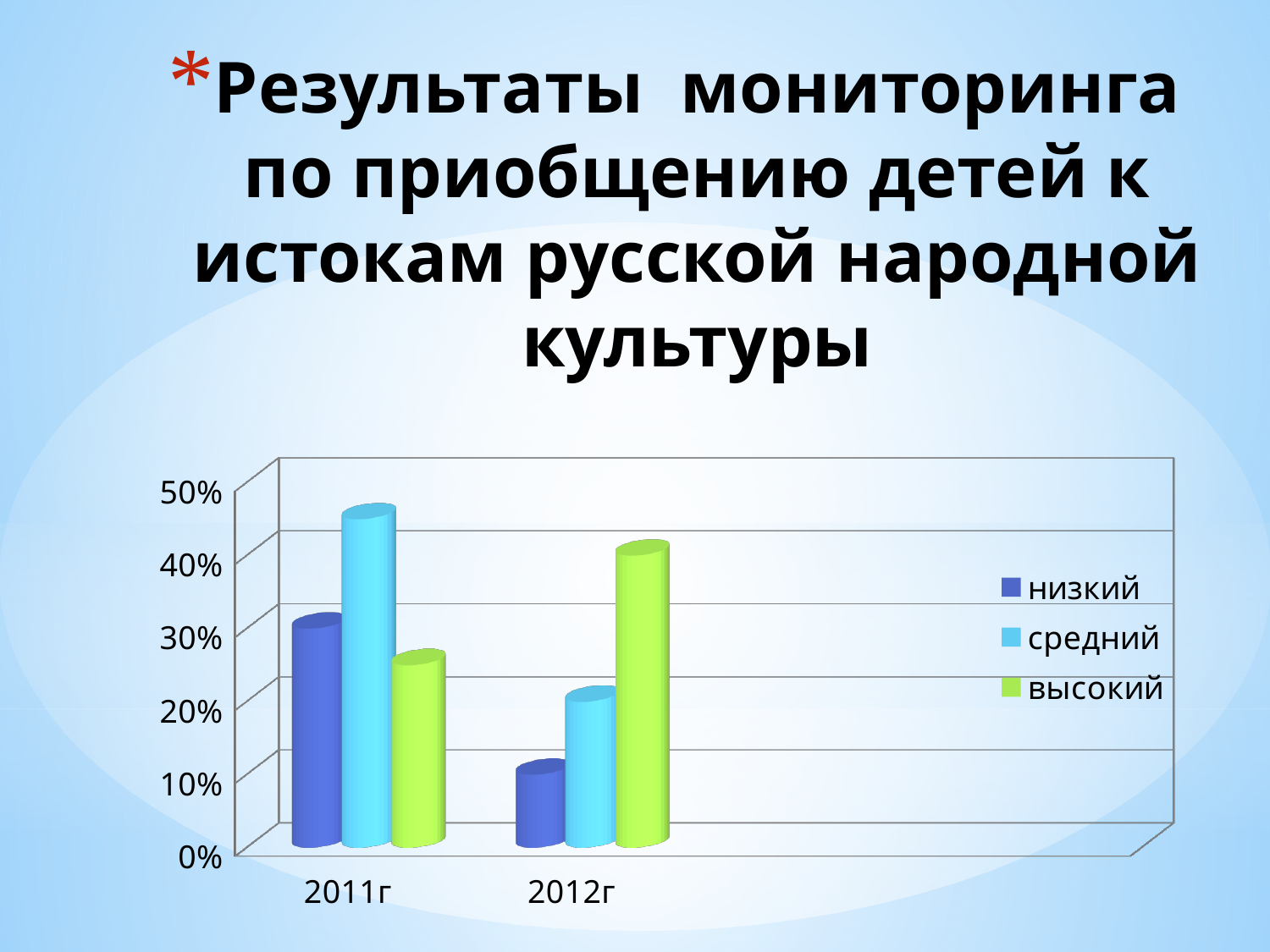
Is the value for высокий in 2012г greater or less than 30%? greater Which series has the highest value for 2011г? средний Does the value for высокий rise or fall from 2011г to 2012г? rise How many series does the legend list? 3 Which series has the lowest value for 2012г? низкий Is the value for средний in 2011г greater or less than 40%? greater How many categories are shown on the x axis? 2 Which series has the lowest value for 2011г? высокий Which is larger: the value for низкий in 2011г or in 2012г? 2011г Which series has the highest value for 2012г? высокий What kind of chart is shown on the slide? bar chart What colour are the bars for the series высокий? green